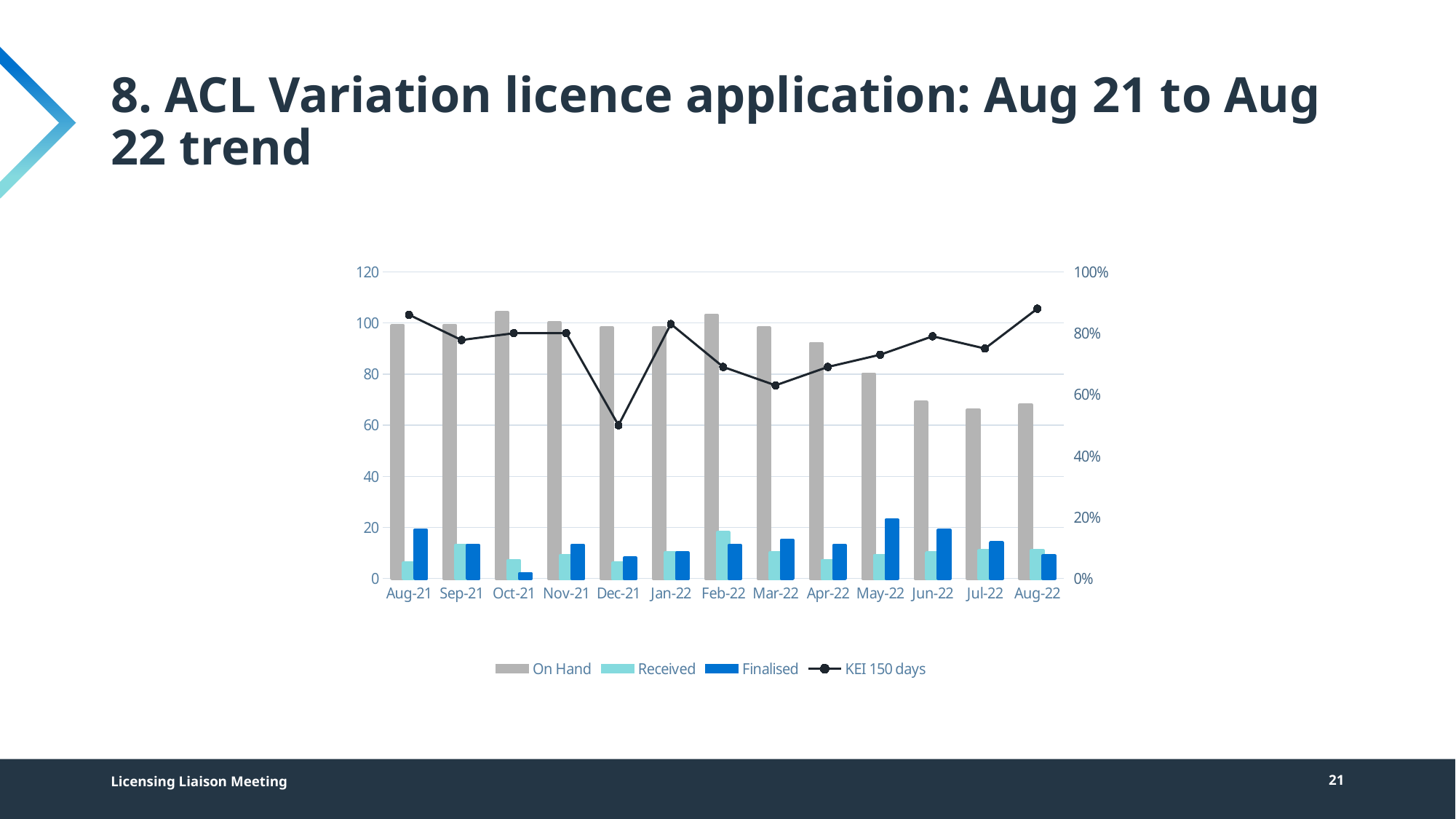
Which month has the highest Finalised value? May-22 How many months are shown on the x axis of the chart? 13 Does the On Hand series generally rise or fall from Aug-21 to Aug-22? Fall Is the On Hand value for Jul-22 greater or less than 80? less What kind of chart is shown on the slide? Bar chart with a line series Is the KEI 150 days value for Dec-21 greater or less than 60%? less Is the On Hand value for Oct-21 greater or less than 100? greater Which month has the lowest Finalised value? Oct-21 Which month has the highest Received value? Feb-22 Which month has the lowest KEI 150 days value? Dec-21 Which is larger, the On Hand value for Aug-21 or for Jul-22? Aug-21 How many series does the chart legend list? 4